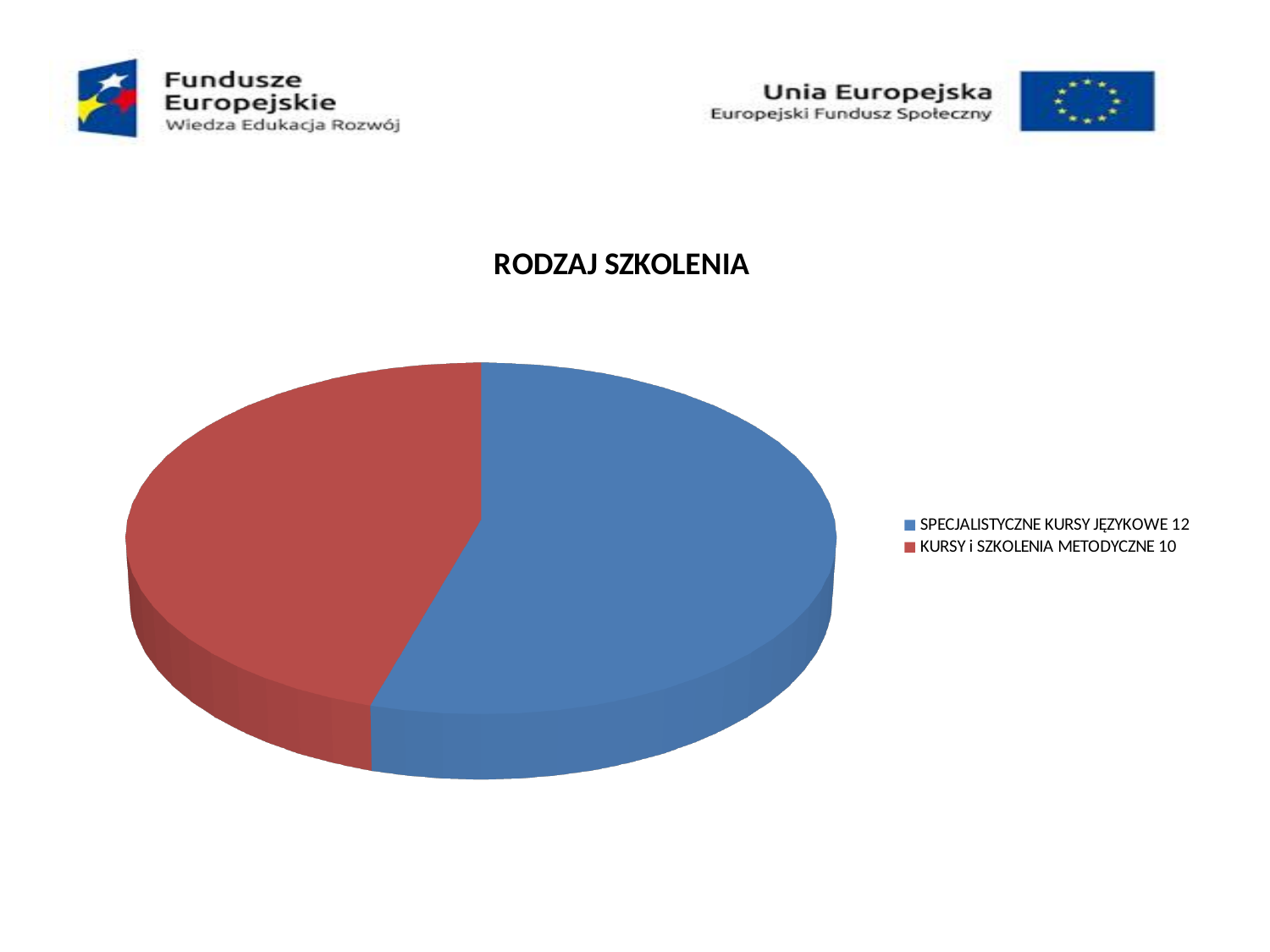
Which category has the smallest slice of the pie? KURSY i SZKOLENIA METODYCZNE Which colour represents KURSY i SZKOLENIA METODYCZNE in the pie chart? red What is the difference between the values for SPECJALISTYCZNE KURSY JĘZYKOWE and KURSY i SZKOLENIA METODYCZNE? 2 How many slices does the pie chart have? 2 What kind of chart is shown on the slide? pie chart What is the value for SPECJALISTYCZNE KURSY JĘZYKOWE? 12 What is the total of the two values shown in the pie chart? 22 What is the value for KURSY i SZKOLENIA METODYCZNE? 10 Which is larger: SPECJALISTYCZNE KURSY JĘZYKOWE or KURSY i SZKOLENIA METODYCZNE? SPECJALISTYCZNE KURSY JĘZYKOWE Which category has the largest slice of the pie? SPECJALISTYCZNE KURSY JĘZYKOWE What is the title of the chart? RODZAJ SZKOLENIA